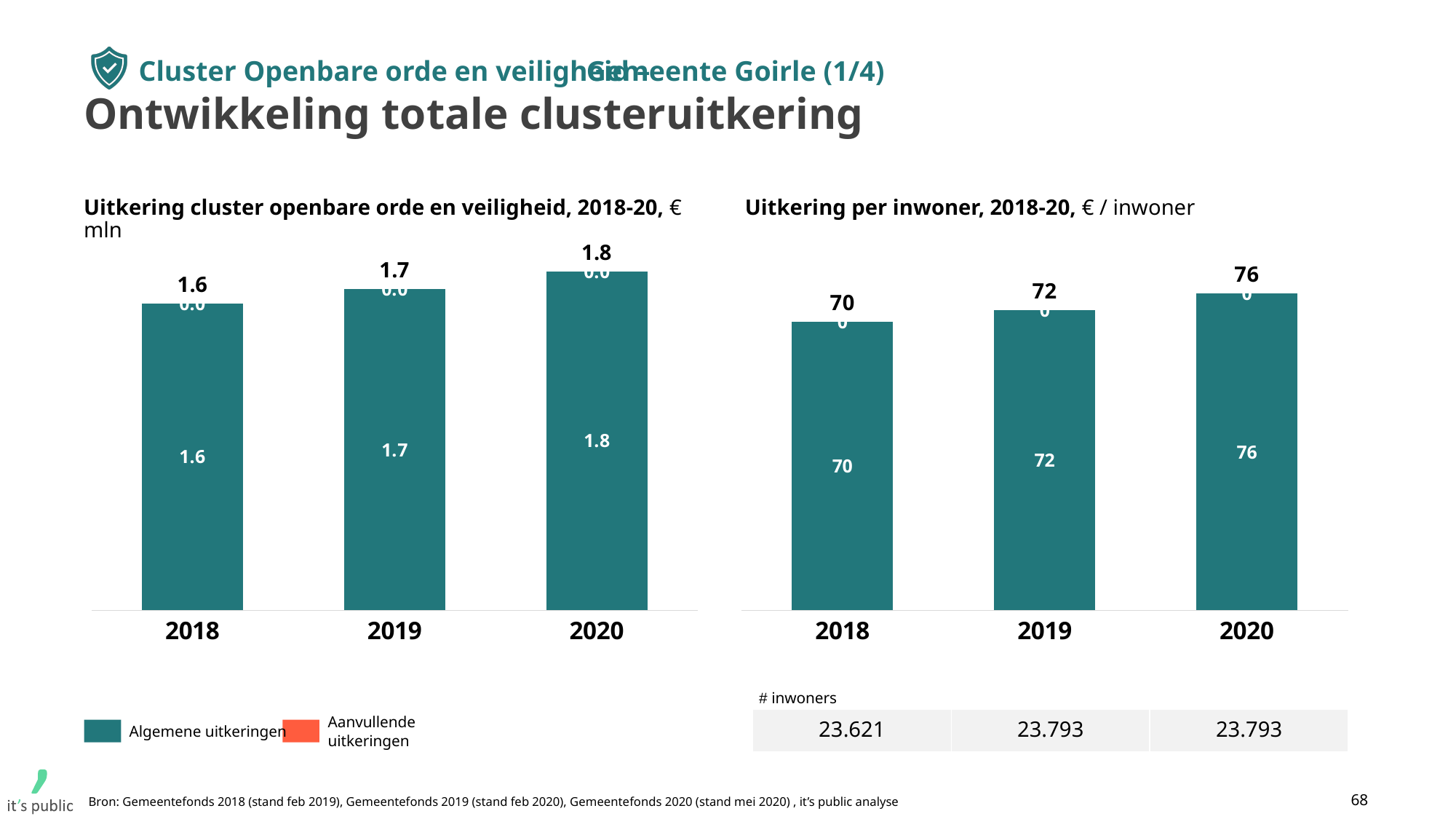
What kind of chart is the right chart (Uitkering per inwoner)? bar chart In the left chart (Uitkering cluster openbare orde en veiligheid), which year has the highest total? 2020 In the right chart (Uitkering per inwoner), what is the value for 2019? 72 In the left chart (Uitkering cluster openbare orde en veiligheid), what is the total value for 2018? 1.6 In the left chart (Uitkering cluster openbare orde en veiligheid), what is the total value for 2020? 1.8 In the right chart (Uitkering per inwoner), which year has the lowest value? 2018 In the left chart (Uitkering cluster openbare orde en veiligheid), do the totals rise or fall from 2018 to 2020? rise In the left chart (Uitkering cluster openbare orde en veiligheid), what is the value of Algemene uitkeringen for 2019? 1.7 In the right chart (Uitkering per inwoner), what is the value for 2020? 76 In the right chart (Uitkering per inwoner), what is the difference between the 2020 and 2018 values? 6 In the left chart (Uitkering cluster openbare orde en veiligheid), how many series does the legend list? 2 In the right chart (Uitkering per inwoner), how many years are shown on the x axis? 3